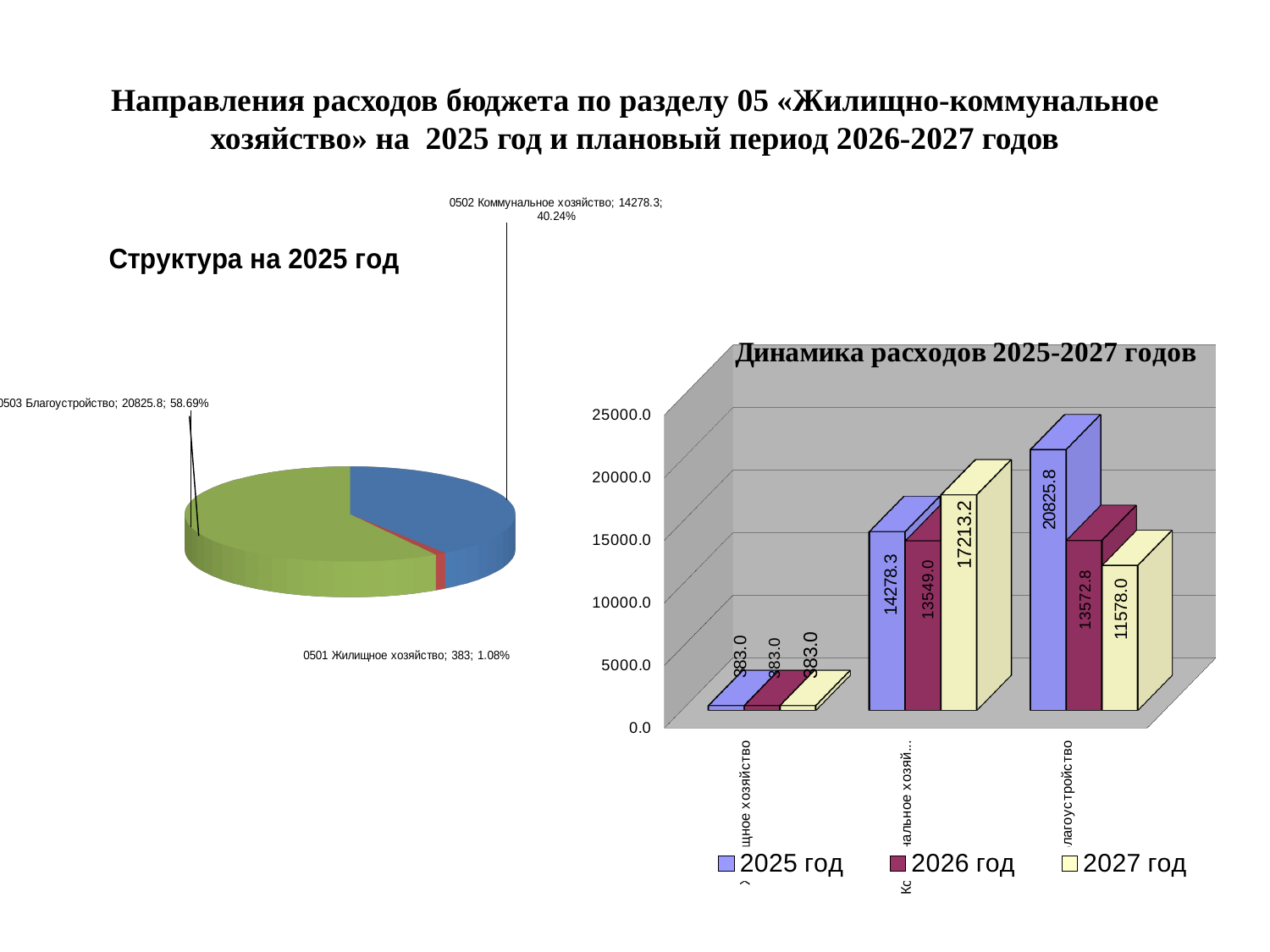
How many slices does the pie chart 'Структура на 2025 год' have? 3 In the pie chart 'Структура на 2025 год', which slice is the smallest? 0501 Жилищное хозяйство In the chart 'Динамика расходов 2025-2027 годов', do the values for Благоустройство rise or fall from 2025 год to 2027 год? Fall In the chart 'Динамика расходов 2025-2027 годов', what is the value for Благоустройство in 2025 год? 20825.8 In the chart 'Динамика расходов 2025-2027 годов', what is the value for Коммунальное хозяйство in 2027 год? 17213.2 In the chart 'Динамика расходов 2025-2027 годов', what is the difference between the 2025 год and 2027 год values for Благоустройство? 9247.8 In the chart 'Динамика расходов 2025-2027 годов', which is larger for Коммунальное хозяйство: the 2026 год value or the 2027 год value? 2027 год In the pie chart 'Структура на 2025 год', what value is shown for 0502 Коммунальное хозяйство? 14278.3 In the pie chart 'Структура на 2025 год', what percentage is shown for 0501 Жилищное хозяйство? 1.08% In the pie chart 'Структура на 2025 год', what share does 0503 Благоустройство have? 58.69% How many series does the legend of the chart 'Динамика расходов 2025-2027 годов' list? 3 What type of chart is 'Динамика расходов 2025-2027 годов'? Bar chart